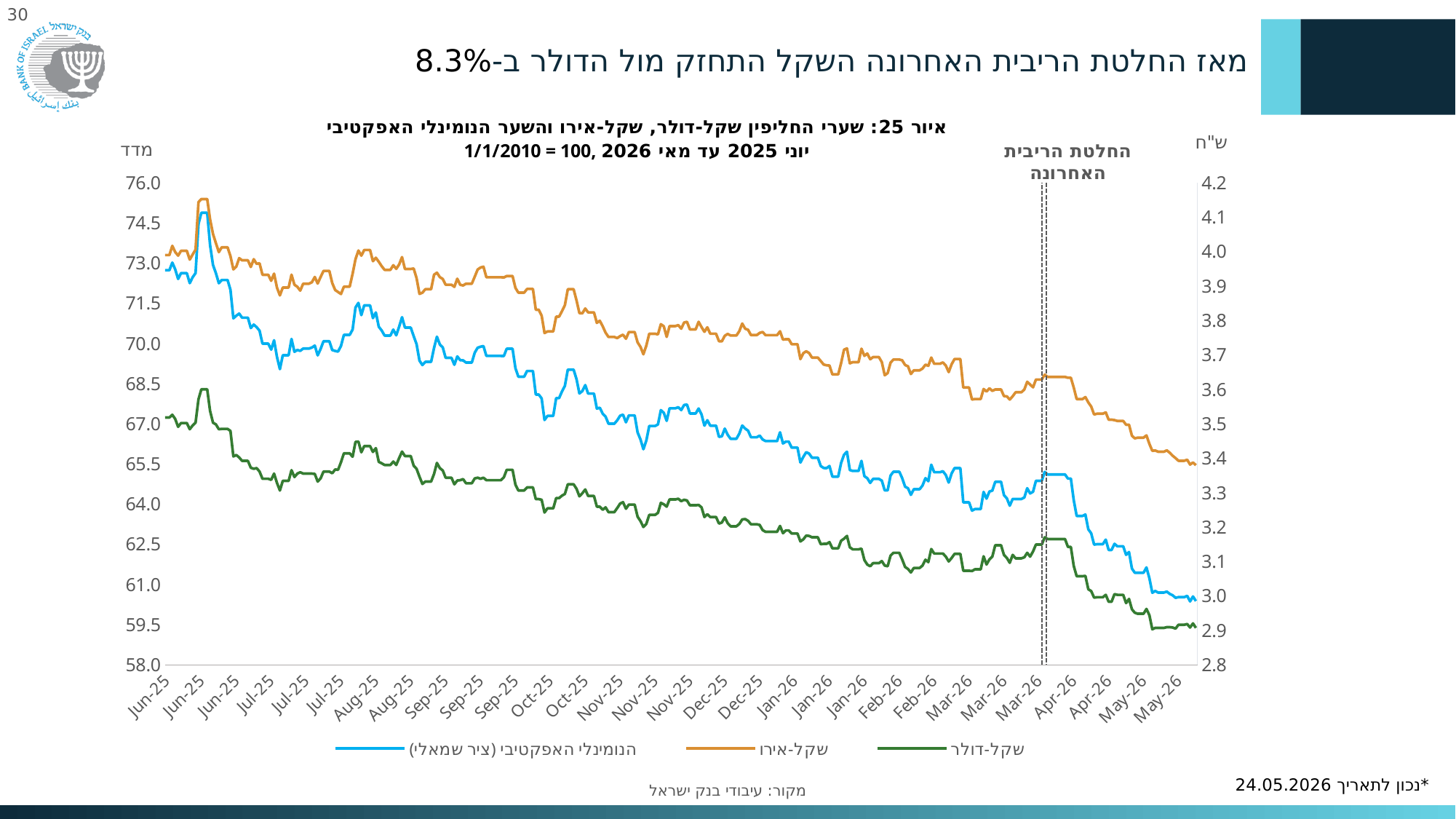
At the end of May-26, which is higher on the right axis: שקל-אירו or שקל-דולר? שקל-אירו What kind of chart is shown on the slide? line chart What is the label of the dashed vertical line near Mar-26? החלטת הריבית האחרונה At the end of May-26, is the שקל-אירו value greater or less than 3.5? less At the start of Jun-25, is the שקל-אירו value greater or less than 3.9? greater Which series is plotted on the left axis according to the legend? הנומינלי האפקטיבי (ציר שמאלי) Does the שקל-אירו series rise or fall overall from Jun-25 to May-26? fall At the end of May-26, is the הנומינלי האפקטיבי index greater or less than 62.5? less Does the שקל-דולר series rise or fall overall from Jun-25 to May-26? fall How many series does the legend list? 3